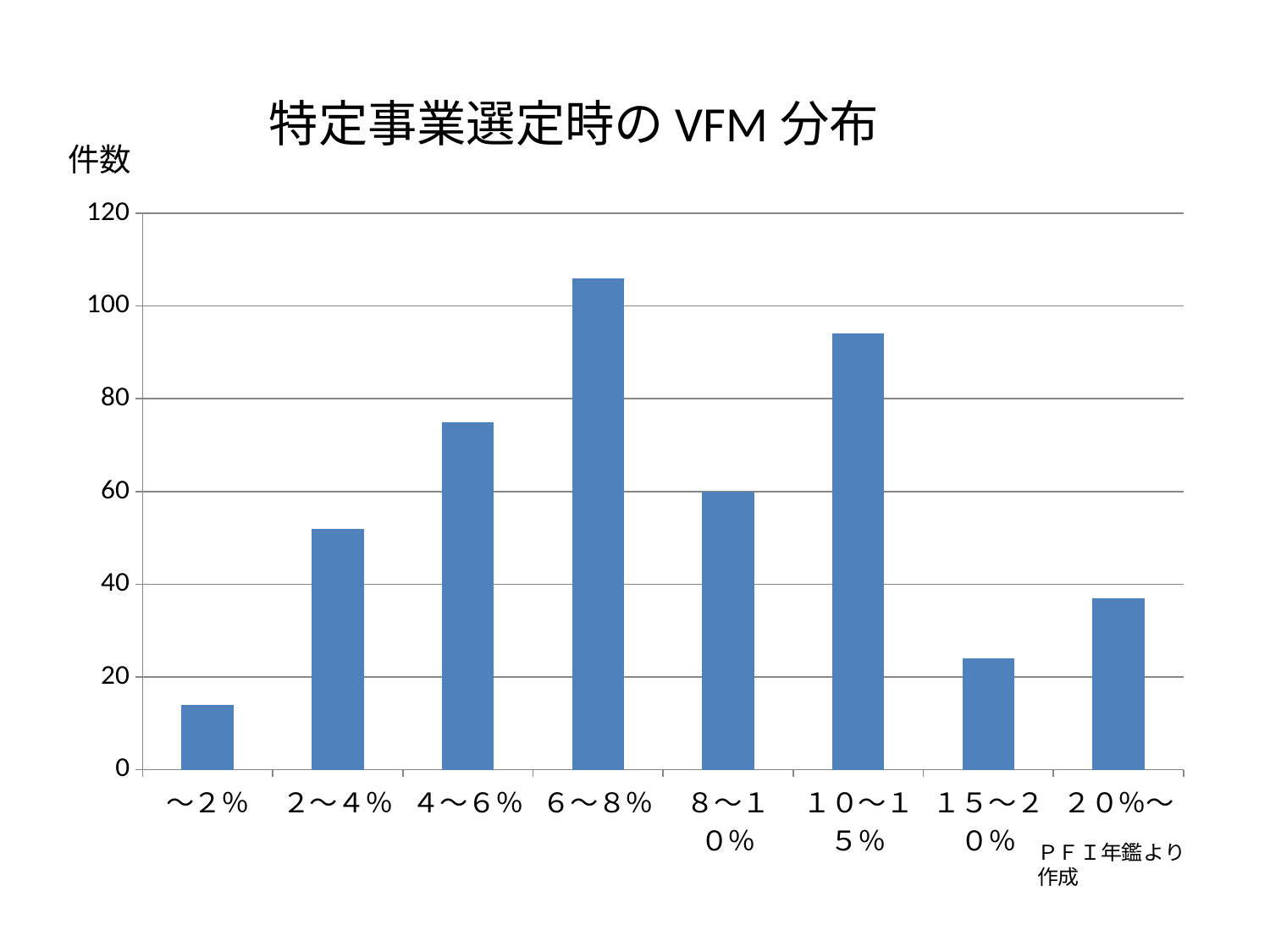
Is the value for ４～６％ greater or less than 60? greater What kind of chart is shown on the slide? bar chart Is the value for １５～２０％ greater or less than 40? less What is the value for the ８～１０％ category? 60 Do the values rise or fall from ～２％ to ６～８％ along the x axis? rise Which is larger, the value for １０～１５％ or the value for ４～６％? １０～１５％ Which category has the highest value in the chart? ６～８％ Which category has the lowest value in the chart? ～２％ Which is larger, the value for ２～４％ or the value for ２０％～? ２～４％ Is the value for ６～８％ greater or less than 100? greater What is the title of the chart? 特定事業選定時の VFM 分布 How many categories are shown on the x axis of the chart? 8